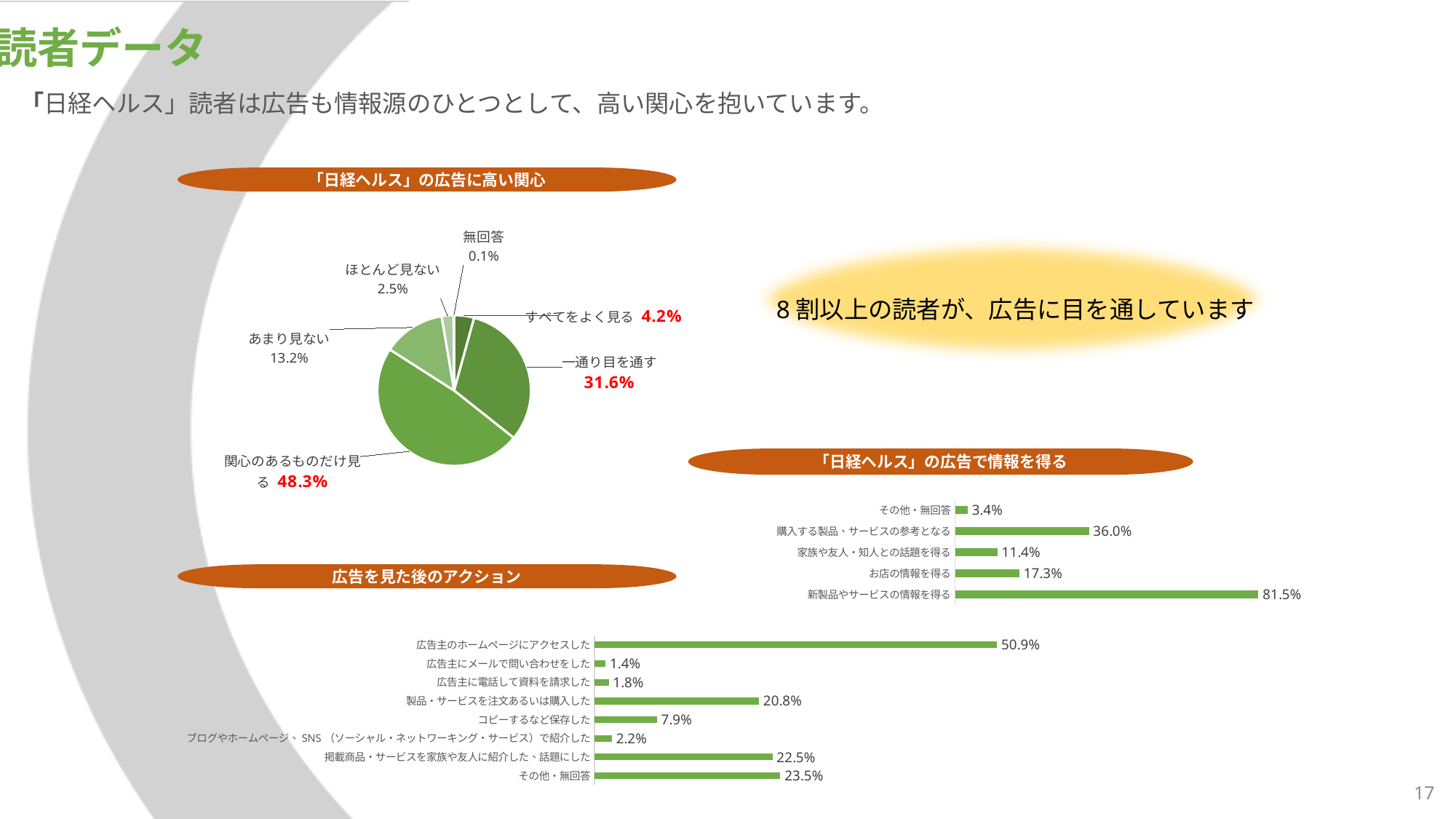
In the chart titled 広告を見た後のアクション, how many categories are shown? 8 In the pie chart titled 「日経ヘルス」の広告に高い関心, what percentage is shown for 関心のあるものだけ見る? 48.3% In the pie chart titled 「日経ヘルス」の広告に高い関心, what is the difference between あまり見ない and ほとんど見ない? 10.7% In the chart titled 「日経ヘルス」の広告で情報を得る, which is larger: お店の情報を得る or 家族や友人・知人との話題を得る? お店の情報を得る In the chart titled 「日経ヘルス」の広告で情報を得る, which category has the lowest value? その他・無回答 In the chart titled 広告を見た後のアクション, what is the value for 製品・サービスを注文あるいは購入した? 20.8% In the chart titled 広告を見た後のアクション, which category has the highest value? 広告主のホームページにアクセスした In the pie chart titled 「日経ヘルス」の広告に高い関心, how many slices are there? 6 In the pie chart titled 「日経ヘルス」の広告に高い関心, what percentage is shown for 一通り目を通す? 31.6% What type of chart is the one titled 広告を見た後のアクション? Bar chart In the pie chart titled 「日経ヘルス」の広告に高い関心, which category has the smallest share? 無回答 In the chart titled 「日経ヘルス」の広告で情報を得る, what is the value for 新製品やサービスの情報を得る? 81.5%